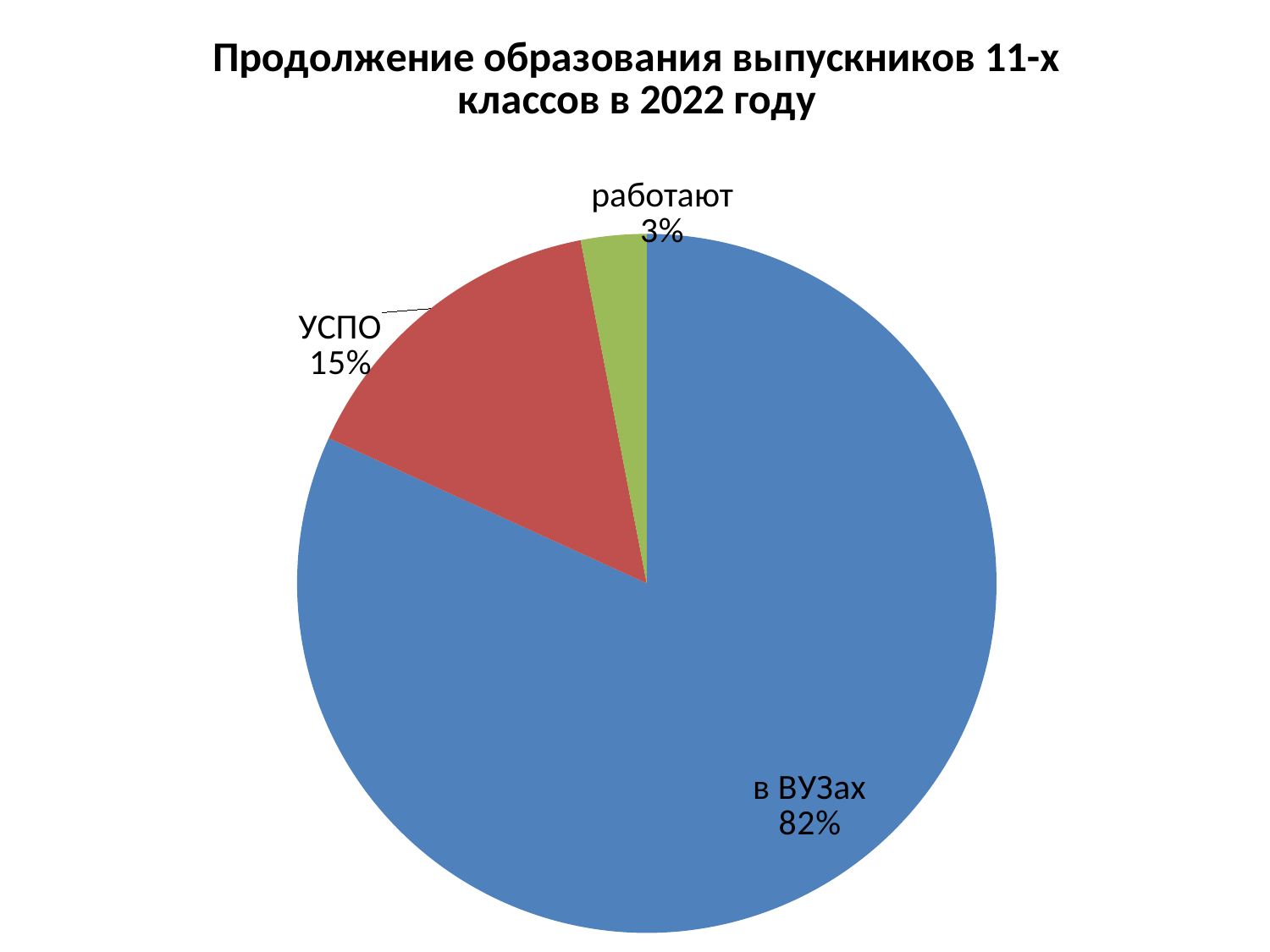
What is the difference in percentage points between the "в ВУЗах" and "УСПО" slices? 67 What is the title of the chart? Продолжение образования выпускников 11-х классов в 2022 году What share of the pie does the "в ВУЗах" slice represent? 82% Which category has the smallest slice of the pie? работают What colour is the "УСПО" slice? red How many slices does the pie chart have? 3 Which slice is larger, "УСПО" or "работают"? УСПО What share of the pie does the "работают" slice represent? 3% What is the difference in percentage points between the "УСПО" and "работают" slices? 12 What kind of chart is shown on the slide? pie chart What share of the pie does the "УСПО" slice represent? 15% Which category has the largest slice of the pie? в ВУЗах